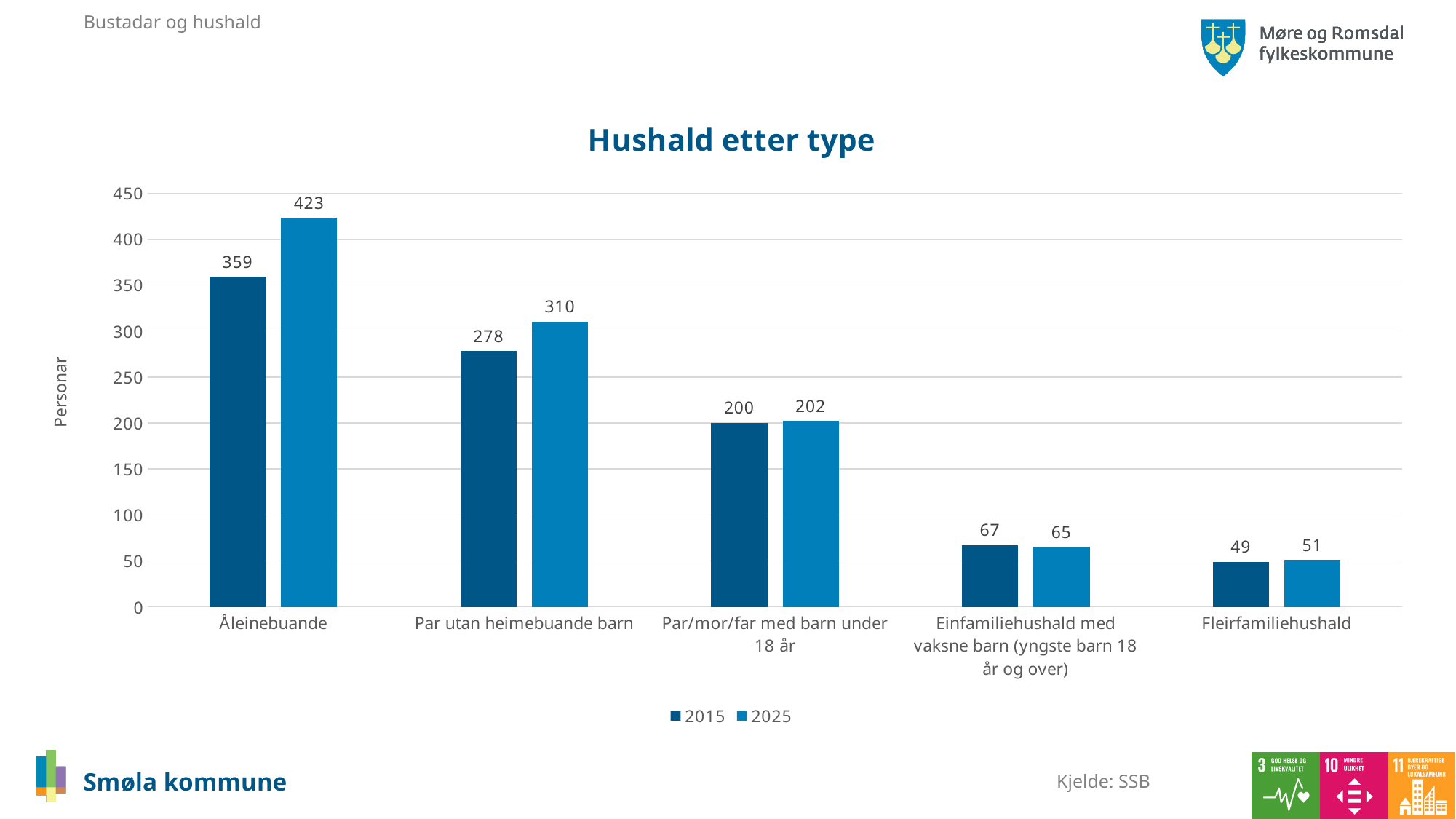
What is the value for Åleinebuande in 2025? 423 Which category has the lowest value in 2025? Fleirfamiliehushald What is the difference between the 2025 and 2015 values for Par utan heimebuande barn? 32 Which category has the highest value in 2015? Åleinebuande What is the title of the chart? Hushald etter type How many household type categories are shown on the x axis? 5 Which is larger for Einfamiliehushald med vaksne barn (yngste barn 18 år og over): the 2015 value or the 2025 value? 2015 What is the value for Par utan heimebuande barn in 2015? 278 What kind of chart is shown on the slide? Bar chart How many series does the legend list? 2 What is the difference between the 2025 and 2015 values for Åleinebuande? 64 What is the value for Fleirfamiliehushald in 2025? 51